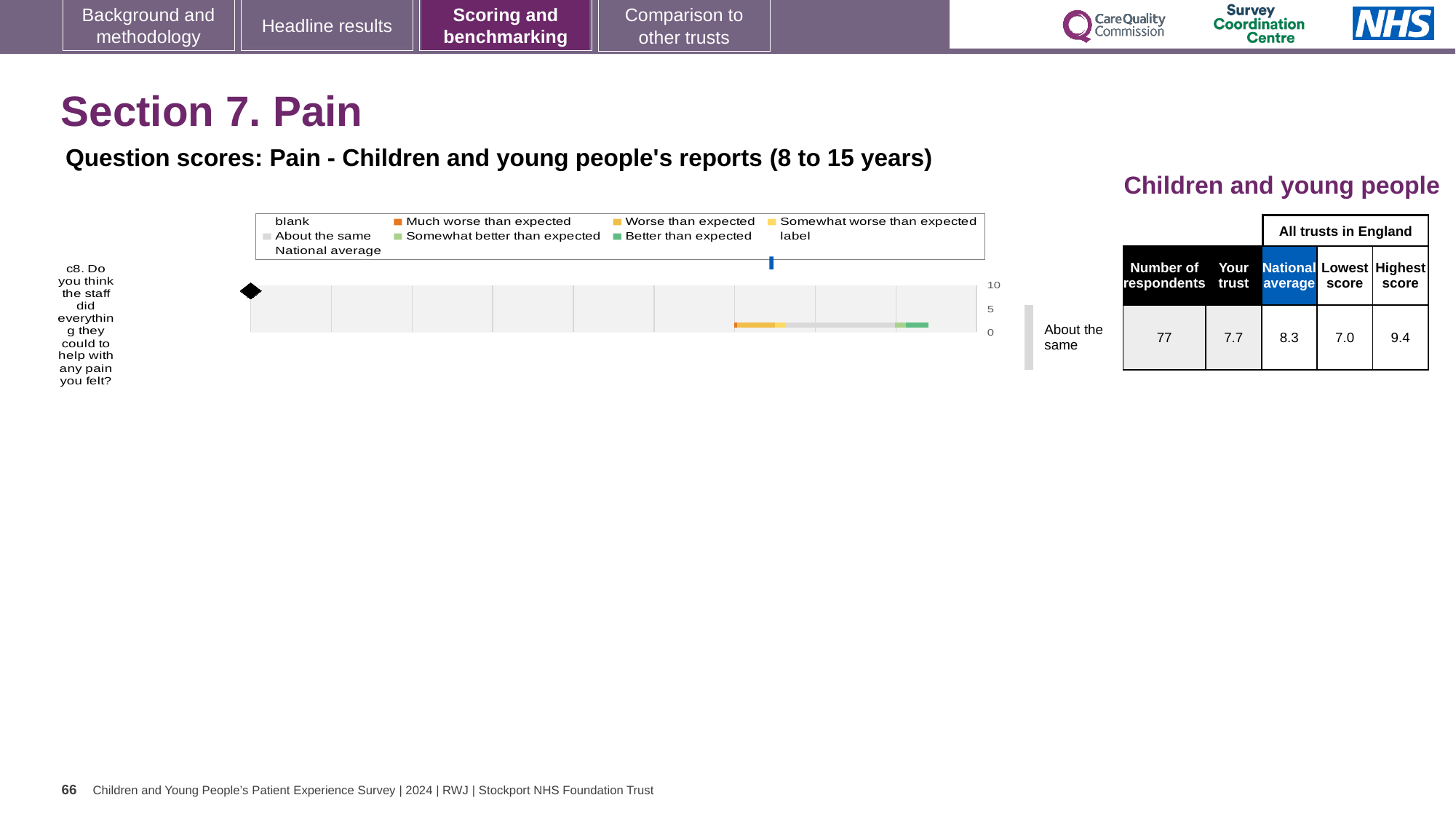
How many respondents answered question c8? 77 What is the highest value shown on the chart's score axis? 10 What is the difference between the highest score and the lowest score for question c8? 2.4 By how much does the national average exceed the 'Your trust' score for question c8? 0.6 What is the 'Your trust' score for question c8 (Do you think the staff did everything they could to help with any pain you felt?)? 7.7 What kind of chart is used to show the question score for c8? bar chart What is the national average score for question c8? 8.3 How many survey questions are plotted on the chart? 1 What is the highest score among all trusts in England for question c8? 9.4 For question c8, which is larger: the 'Your trust' score or the national average? National average What is the lowest score among all trusts in England for question c8? 7.0 What benchmark category is assigned to question c8 on the slide? About the same